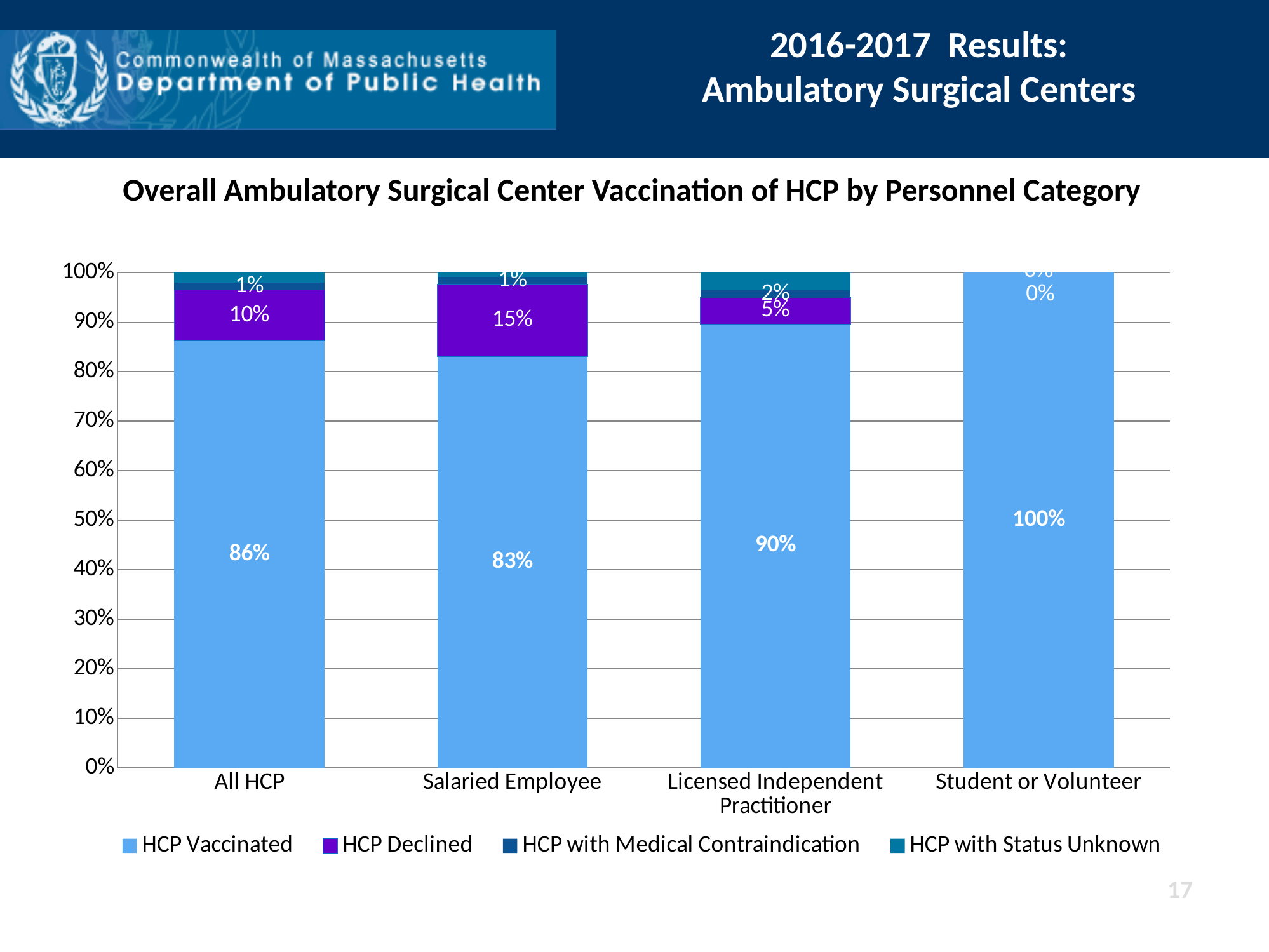
Which has a larger HCP Vaccinated percentage, All HCP or Licensed Independent Practitioner? Licensed Independent Practitioner What is the HCP Declined percentage for Salaried Employee? 15% What is the difference between the HCP Declined percentage for Salaried Employee and for All HCP? 5% Which personnel category has the highest HCP Vaccinated percentage? Student or Volunteer What is the HCP Vaccinated percentage for Salaried Employee? 83% How many personnel categories are shown on the x axis? 4 What is the HCP Vaccinated percentage for All HCP? 86% What is the HCP Vaccinated percentage for Student or Volunteer? 100% Which personnel category has the lowest HCP Vaccinated percentage? Salaried Employee What is the HCP Vaccinated percentage for Licensed Independent Practitioner? 90% What is the HCP Declined percentage for Licensed Independent Practitioner? 5% How many series does the legend list? 4